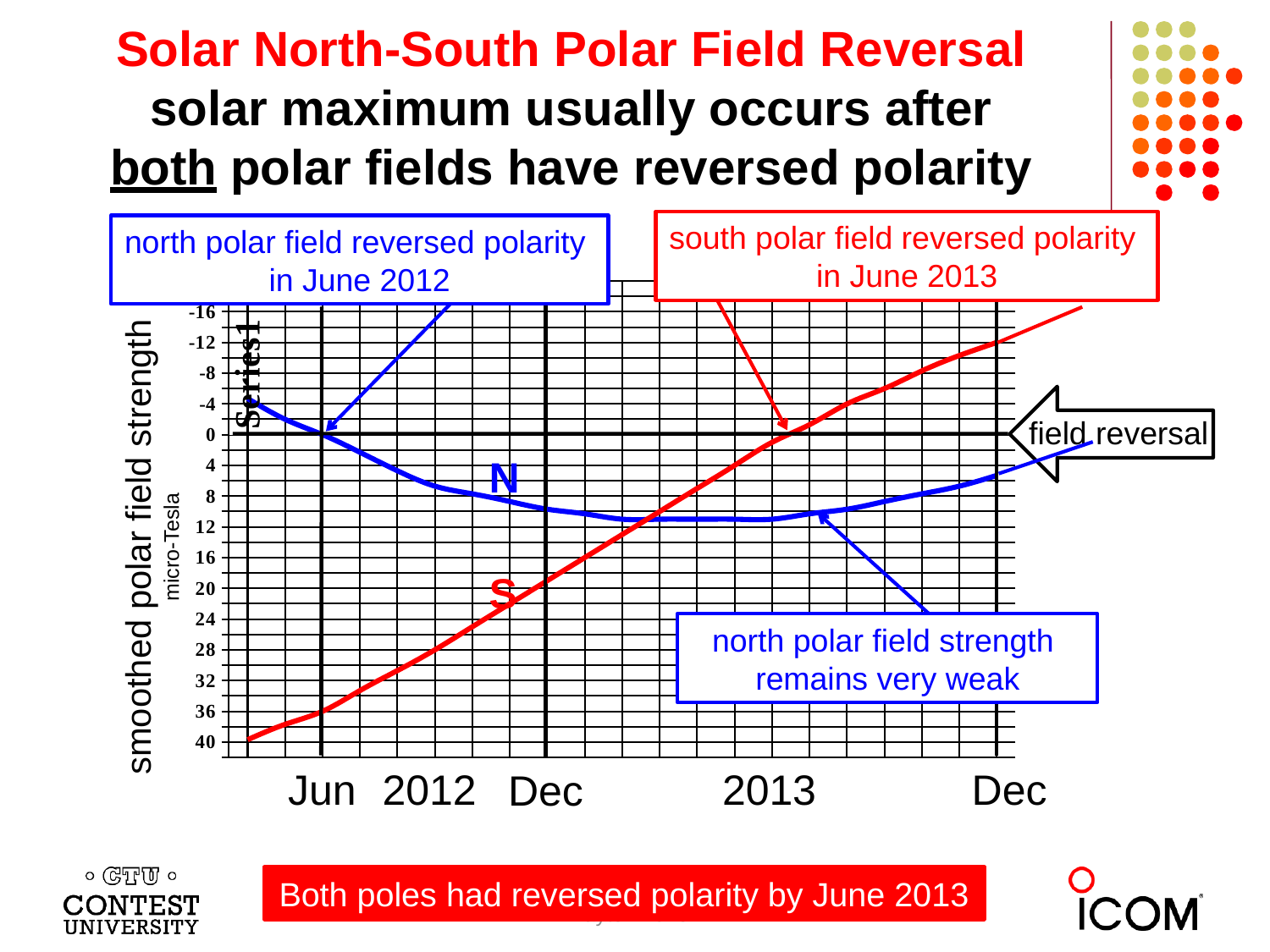
What kind of chart is shown on the slide? line chart Is the value of the S line at Dec 2013 greater or less than 0? less How many data series (lines) are plotted on the chart? 2 Is the value of the N line at Dec 2012 greater or less than 4? greater At Dec 2013, which line has the larger value, N or S? N Do the values of the S line increase or decrease from left to right along the x axis? decrease What is the value of the N (north polar field) line at Jun 2012? 0 At Dec 2012, which line has the larger value, N or S? S What is the lowest tick value shown on the vertical axis? -16 Is the value of the S (south polar field) line at Jun 2012 greater or less than 20? greater What is the label on the vertical axis of the chart? smoothed polar field strength What colour is the line labelled N? blue